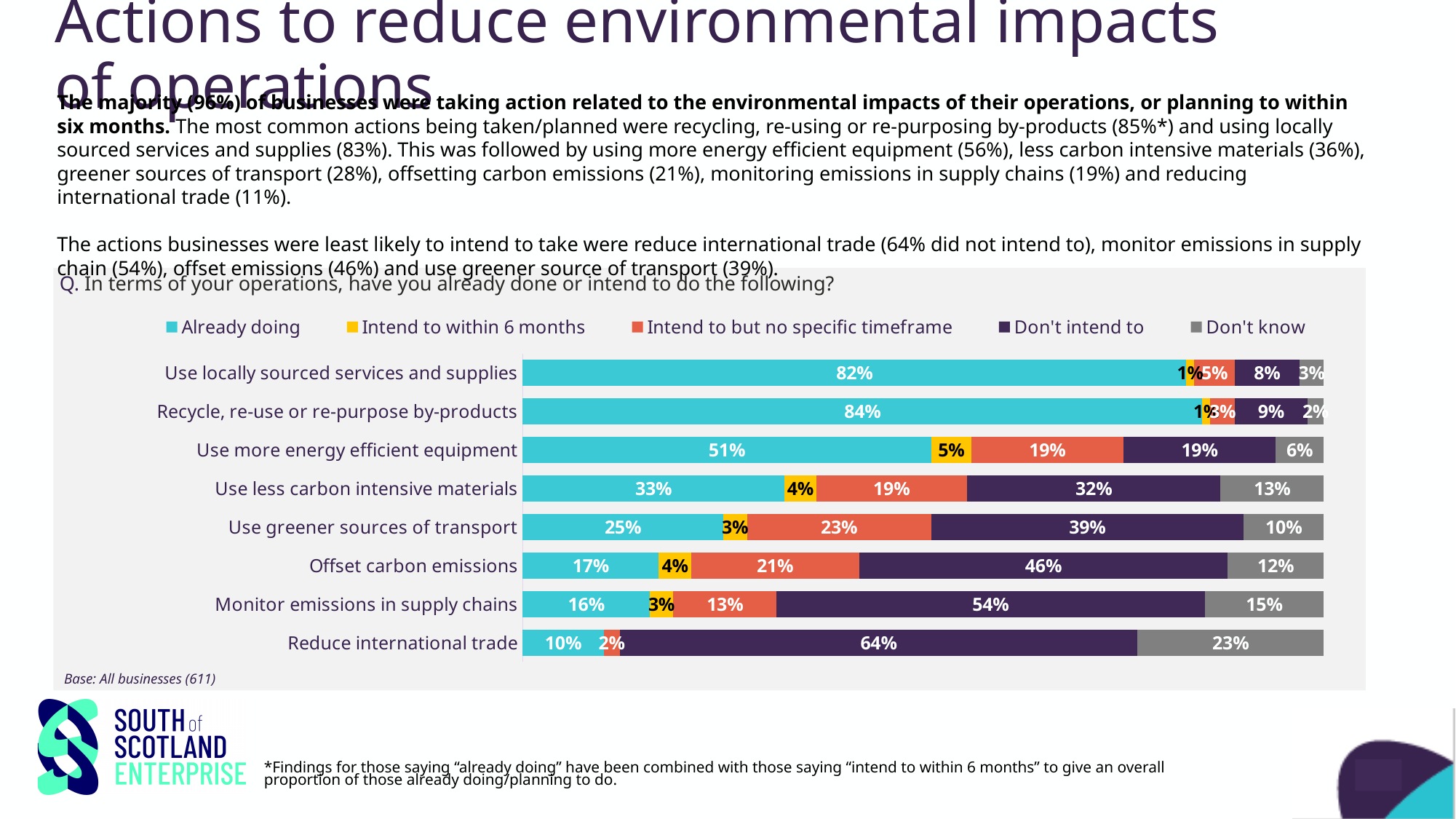
What is the 'Don't intend to' value for 'Reduce international trade'? 64% What is the total of all segments in the 'Use more energy efficient equipment' bar? 100% Which action has the highest 'Already doing' percentage? Recycle, re-use or re-purpose by-products What kind of chart is shown on the slide? Stacked bar chart Which has a larger 'Don't know' value: 'Monitor emissions in supply chains' or 'Use less carbon intensive materials'? Monitor emissions in supply chains How many series does the chart legend list? 5 What is the 'Intend to but no specific timeframe' value for 'Use greener sources of transport'? 23% Which action has the highest 'Don't know' percentage? Reduce international trade What is the difference in the 'Don't intend to' value between 'Offset carbon emissions' and 'Use greener sources of transport'? 7 percentage points What percentage of businesses are 'Already doing' 'Use more energy efficient equipment'? 51% Which action has the lowest 'Already doing' percentage? Reduce international trade How many actions (categories) are plotted in the chart? 8